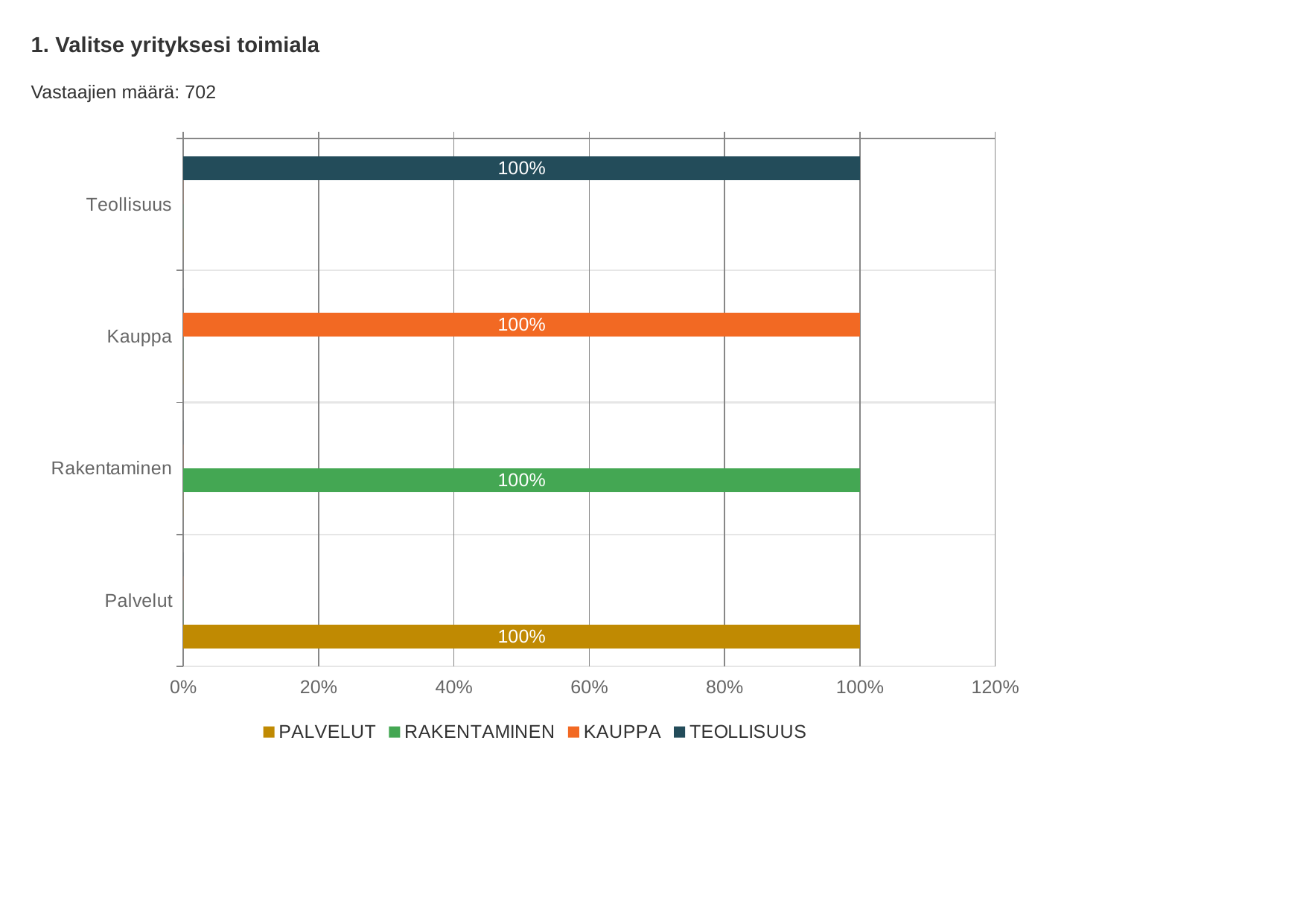
What is the value shown for Kauppa? 100% What is the title of the chart? 1. Valitse yrityksesi toimiala What is the difference between the values for Teollisuus and Palvelut? 0% What is the value shown for Teollisuus? 100% Is the value for Kauppa greater or less than 80%? greater What is the value shown for Palvelut? 100% How many categories are shown on the chart? 4 What kind of chart is shown on the slide? bar chart How many series does the legend list? 4 What is the value shown for Rakentaminen? 100% Is the value for Rakentaminen greater or less than 120%? less How many respondents (Vastaajien määrä) are reported on the slide? 702